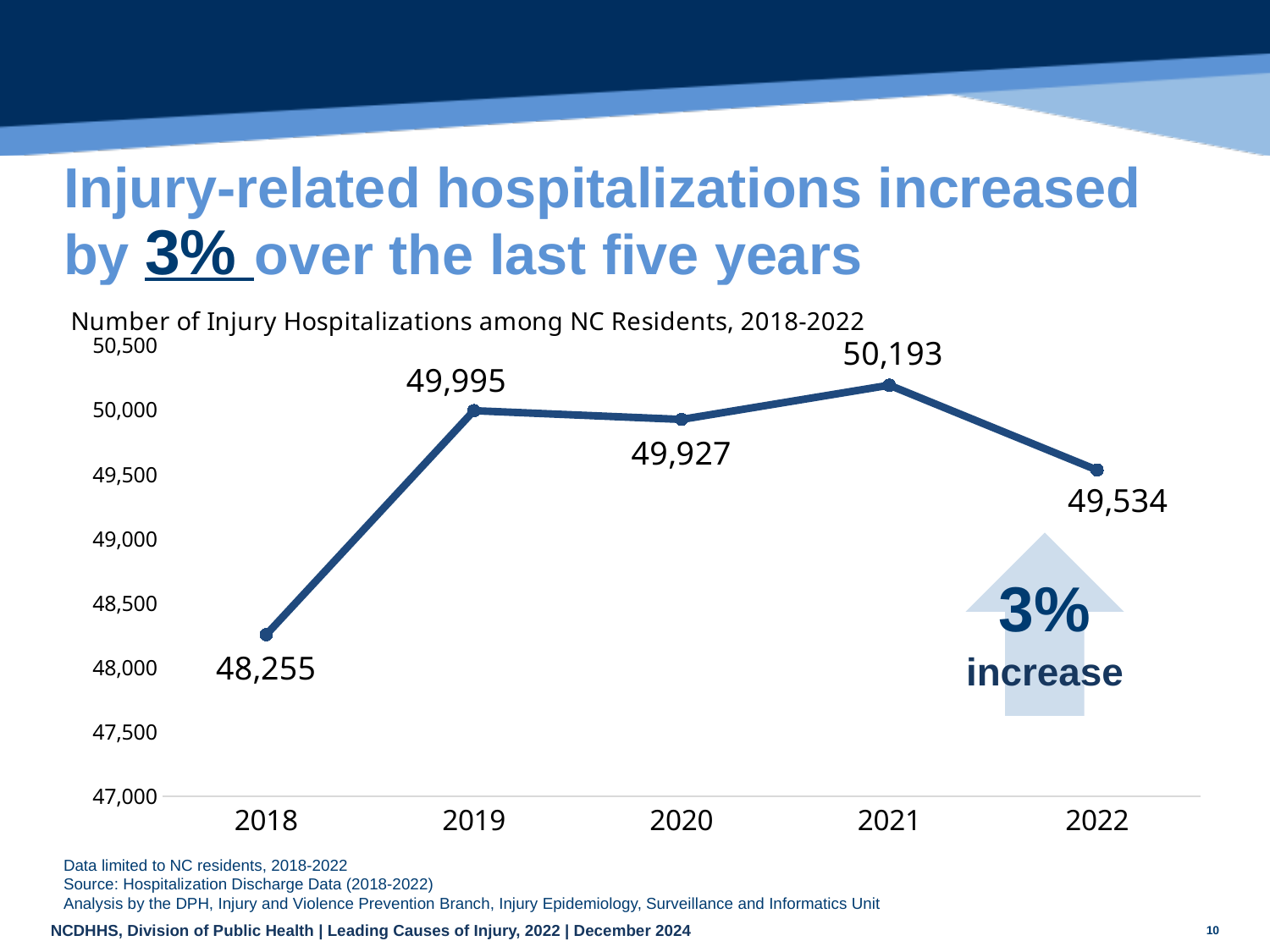
What is the difference in injury hospitalizations between 2019 and 2020? 68 What kind of chart is shown on the slide? line chart How many years are plotted on the chart? 5 What is the title of the chart? Number of Injury Hospitalizations among NC Residents, 2018-2022 What is the difference in injury hospitalizations between 2021 and 2018? 1,938 Which year has the highest number of injury hospitalizations? 2021 Which year has the lowest number of injury hospitalizations? 2018 What is the number of injury hospitalizations in 2021? 50,193 Is the value for 2020 greater or less than 50,000? less What is the number of injury hospitalizations in 2022? 49,534 Which year had more injury hospitalizations, 2019 or 2022? 2019 What is the number of injury hospitalizations in 2018? 48,255